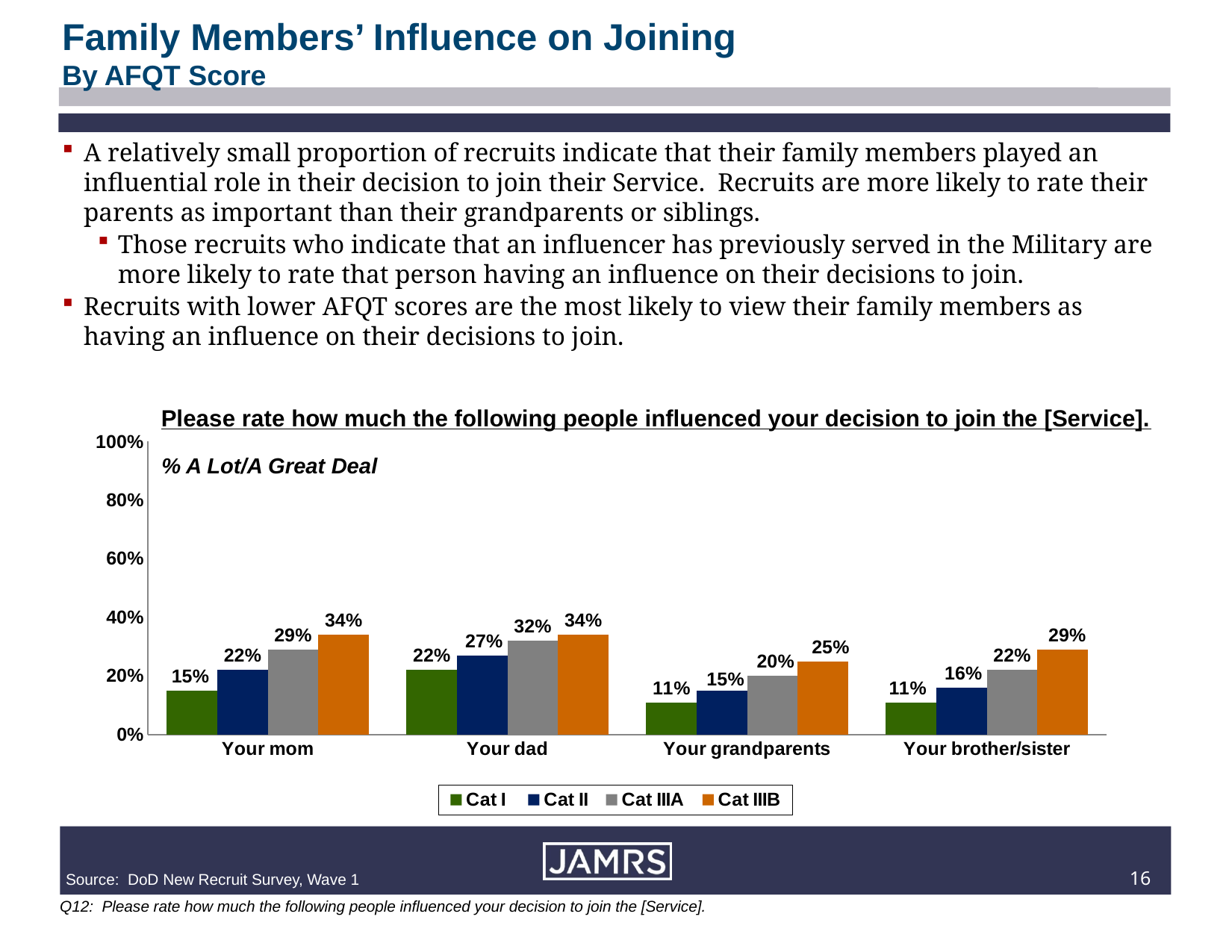
What is the Cat IIIA value for Your brother/sister? 22% What is the difference between the Cat IIIB and Cat I values for Your mom? 19% Which is larger for Your grandparents: the Cat II value or the Cat IIIA value? Cat IIIA How many categories are shown on the x axis? 4 Which category has the highest Cat I value? Your dad What is the Cat II value for Your dad? 27% What kind of chart is shown on the slide? Bar chart What is the Cat IIIB value for Your mom? 34% What is the title of the chart? Please rate how much the following people influenced your decision to join the [Service]. How many series does the legend list? 4 What is the Cat I value for Your grandparents? 11% Which category has the lowest Cat IIIB value? Your grandparents